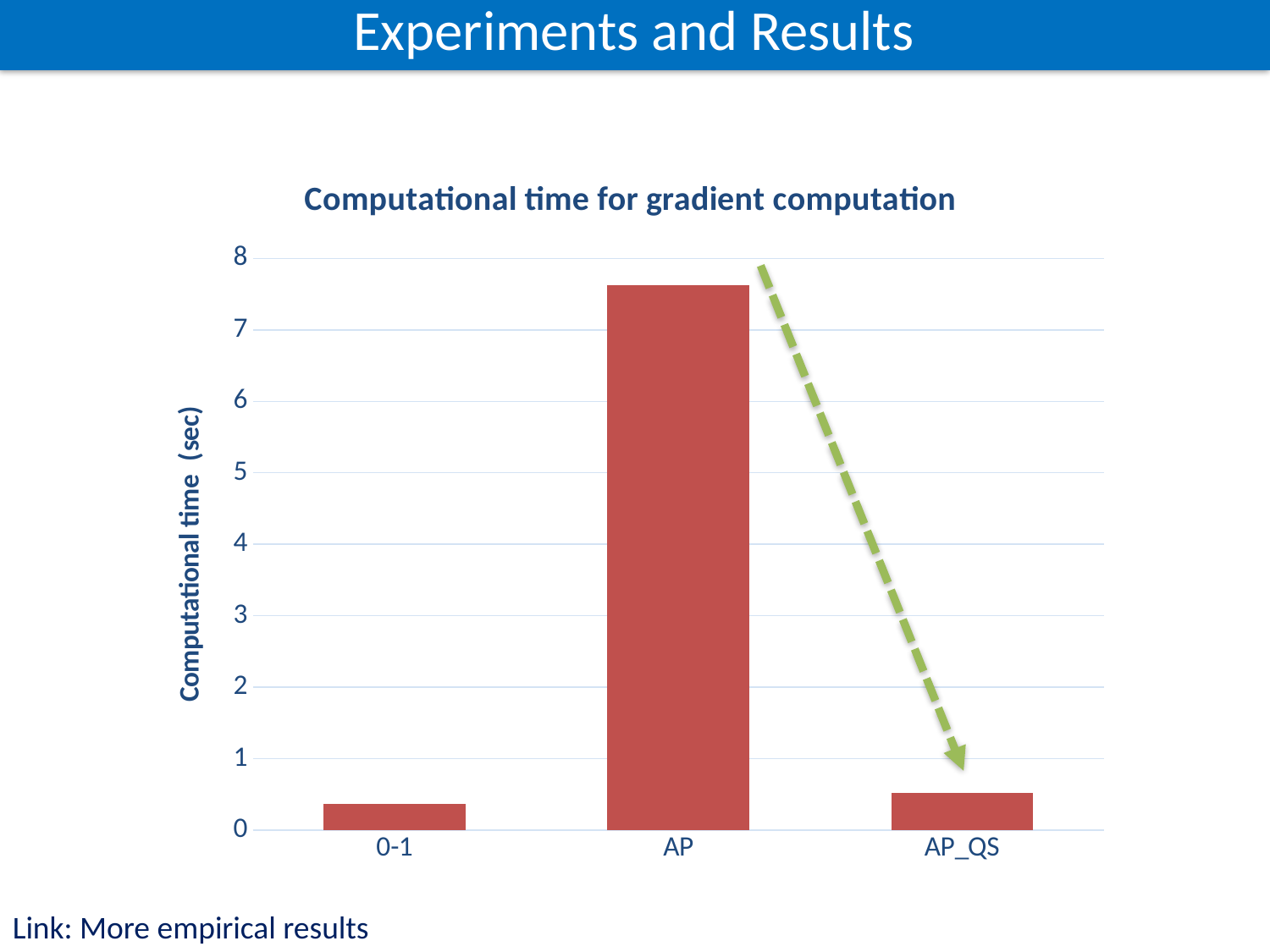
What is the label of the y axis? Computational time (sec) Which category has the highest computational time? AP Which has a larger computational time, AP or AP_QS? AP Which category has the lowest computational time? 0-1 Is the value for AP greater or less than 8? less Is the value for AP_QS greater or less than 1? less Is the value for AP greater or less than 7? greater How many categories are shown on the x axis of the chart? 3 Which has a larger computational time, 0-1 or AP? AP What kind of chart is shown on the slide? bar chart What is the title of the chart? Computational time for gradient computation